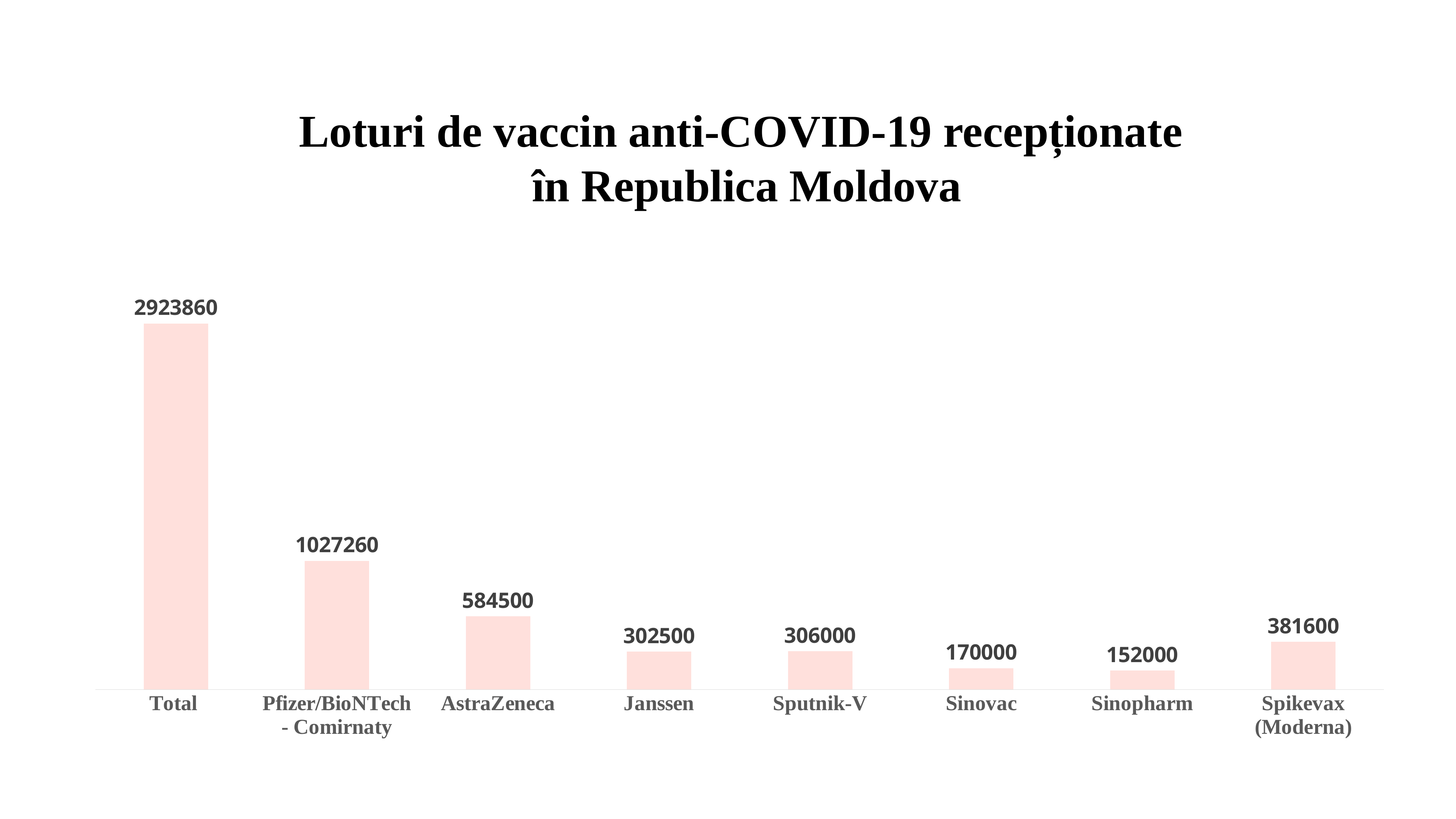
Which category has the lowest value? Sinopharm Excluding the Total bar, which vaccine has the highest value? Pfizer/BioNTech - Comirnaty What type of chart is shown on the slide? Bar chart What is the difference between the values for Sinovac and Sinopharm? 18000 What is the value for Pfizer/BioNTech - Comirnaty? 1027260 What is the value for Spikevax (Moderna)? 381600 What is the difference between the values for Pfizer/BioNTech - Comirnaty and AstraZeneca? 442760 How many bars are shown in the chart? 8 What is the value for AstraZeneca? 584500 What is the value for Sinovac? 170000 What is the value for Total? 2923860 Which is larger, the value for AstraZeneca or the value for Spikevax (Moderna)? AstraZeneca